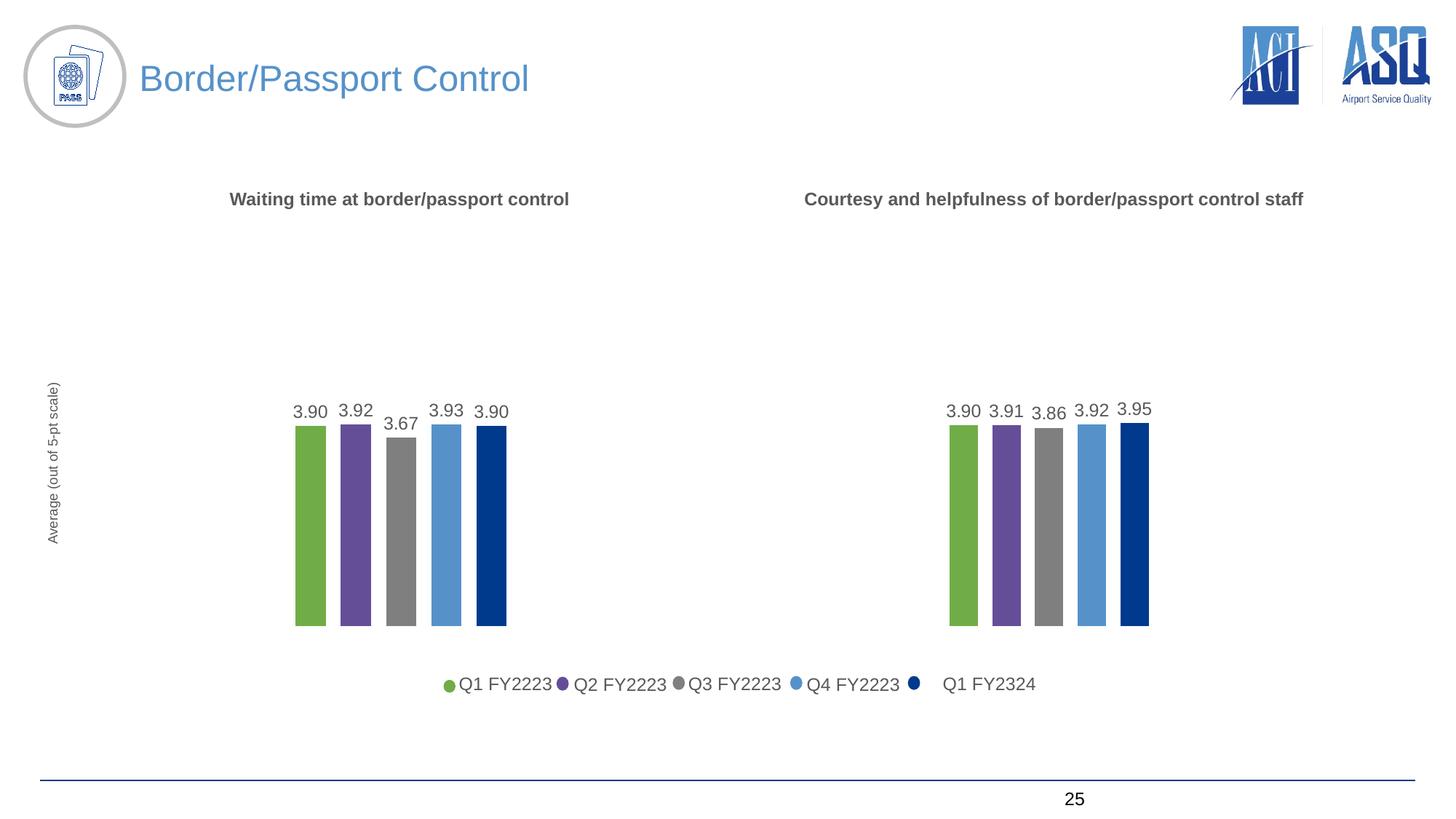
What kind of chart is used on this slide? Bar chart How many series does the legend list? 5 Which colour represents Q1 FY2324 in the legend? Dark blue In the 'Waiting time at border/passport control' chart, what is the difference between the Q4 FY2223 value and the Q3 FY2223 value? 0.26 In the 'Waiting time at border/passport control' chart, which is larger: the value for Q2 FY2223 or the value for Q3 FY2223? Q2 FY2223 In the 'Waiting time at border/passport control' chart, what is the value for Q4 FY2223? 3.93 In the 'Courtesy and helpfulness of border/passport control staff' chart, which quarter has the highest value? Q1 FY2324 In the 'Courtesy and helpfulness of border/passport control staff' chart, what is the difference between the Q1 FY2324 value and the Q3 FY2223 value? 0.09 In the 'Courtesy and helpfulness of border/passport control staff' chart, what is the value for Q3 FY2223? 3.86 In the 'Waiting time at border/passport control' chart, what is the value for Q3 FY2223? 3.67 In the 'Waiting time at border/passport control' chart, which quarter has the lowest value? Q3 FY2223 In the 'Courtesy and helpfulness of border/passport control staff' chart, what is the value for Q1 FY2324? 3.95